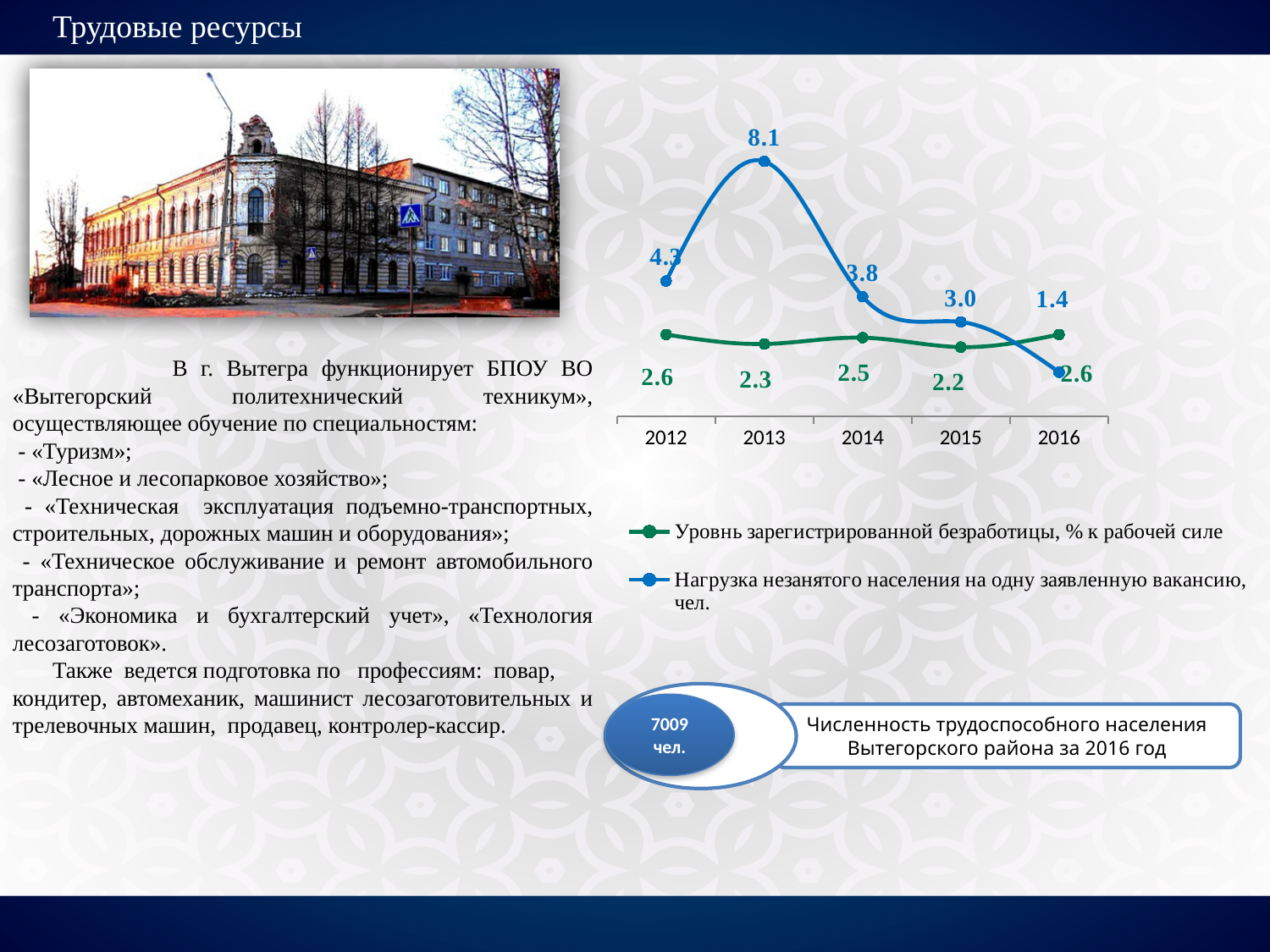
In which year was 'Нагрузка незанятого населения на одну заявленную вакансию, чел.' lowest? 2016 What is the difference between the 2013 and 2014 values of 'Нагрузка незанятого населения на одну заявленную вакансию, чел.'? 4.3 What was the value of 'Нагрузка незанятого населения на одну заявленную вакансию, чел.' in 2013? 8.1 What type of chart is shown on the slide? line chart How many series does the chart legend list? 2 How many years are shown on the x axis of the chart? 5 In which year was 'Нагрузка незанятого населения на одну заявленную вакансию, чел.' highest? 2013 What was the value of 'Нагрузка незанятого населения на одну заявленную вакансию, чел.' in 2016? 1.4 What colour is the line for 'Уровнь зарегистрированной безработицы, % к рабочей силе'? green Did 'Нагрузка незанятого населения на одну заявленную вакансию, чел.' rise or fall from 2013 to 2016? fall What was the value of 'Уровнь зарегистрированной безработицы, % к рабочей силе' in 2015? 2.2 Which series had the larger value in 2012: 'Уровнь зарегистрированной безработицы' or 'Нагрузка незанятого населения на одну заявленную вакансию'? Нагрузка незанятого населения на одну заявленную вакансию